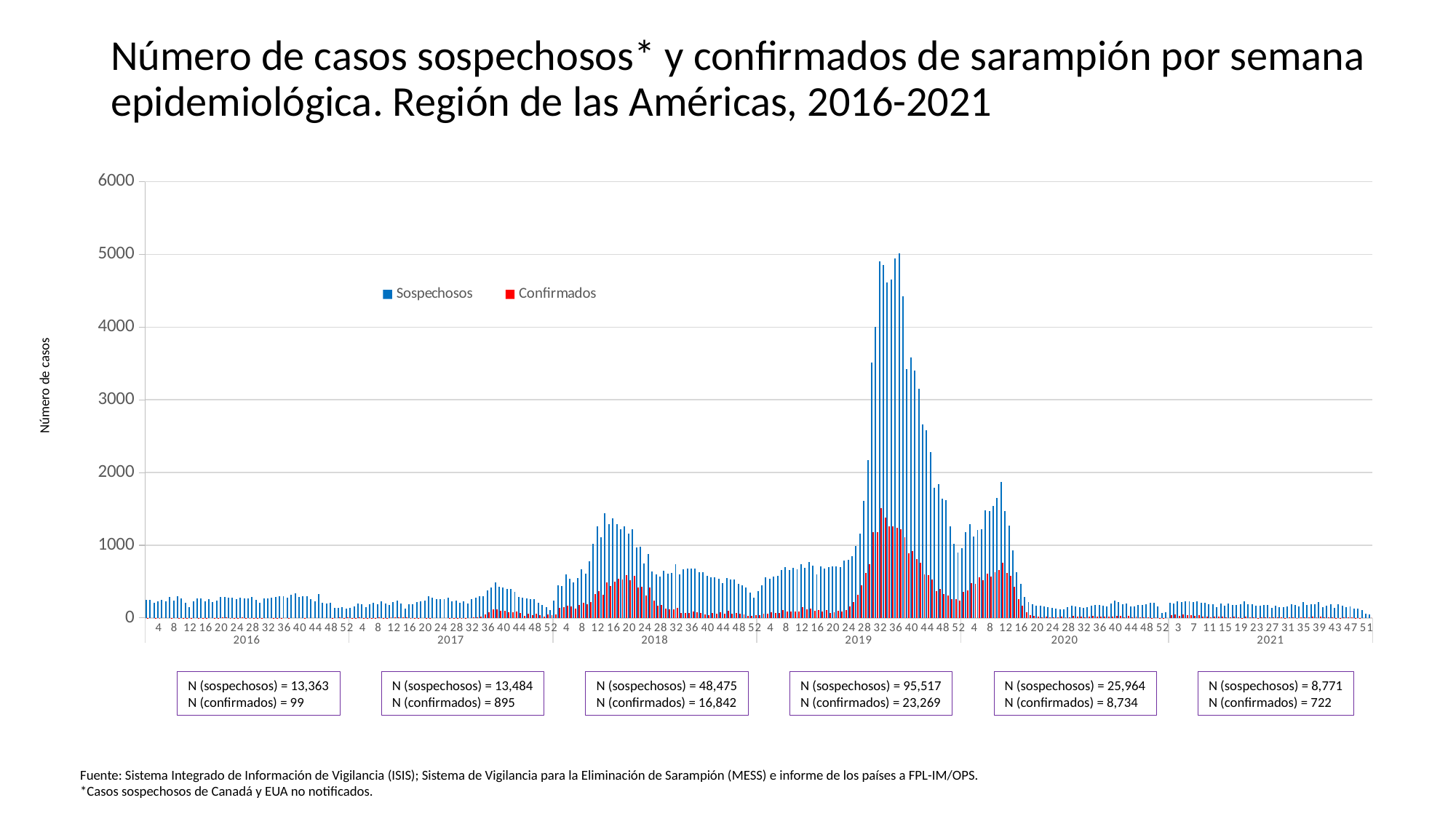
What is N (confirmados) for 2016? 99 What kind of chart is shown on the slide? bar chart Which year has the highest N (sospechosos)? 2019 What is the difference between N (confirmados) for 2019 and N (confirmados) for 2020? 14,535 How many series does the legend list? 2 What is N (sospechosos) for 2019? 95,517 Which year has the lowest N (confirmados)? 2016 What is N (confirmados) for 2018? 16,842 What is the label on the vertical axis? Número de casos What are the two series named in the legend? Sospechosos and Confirmados Is the highest weekly value of Sospechosos in 2019 greater or less than 4000? greater How many years are shown along the x axis? 6